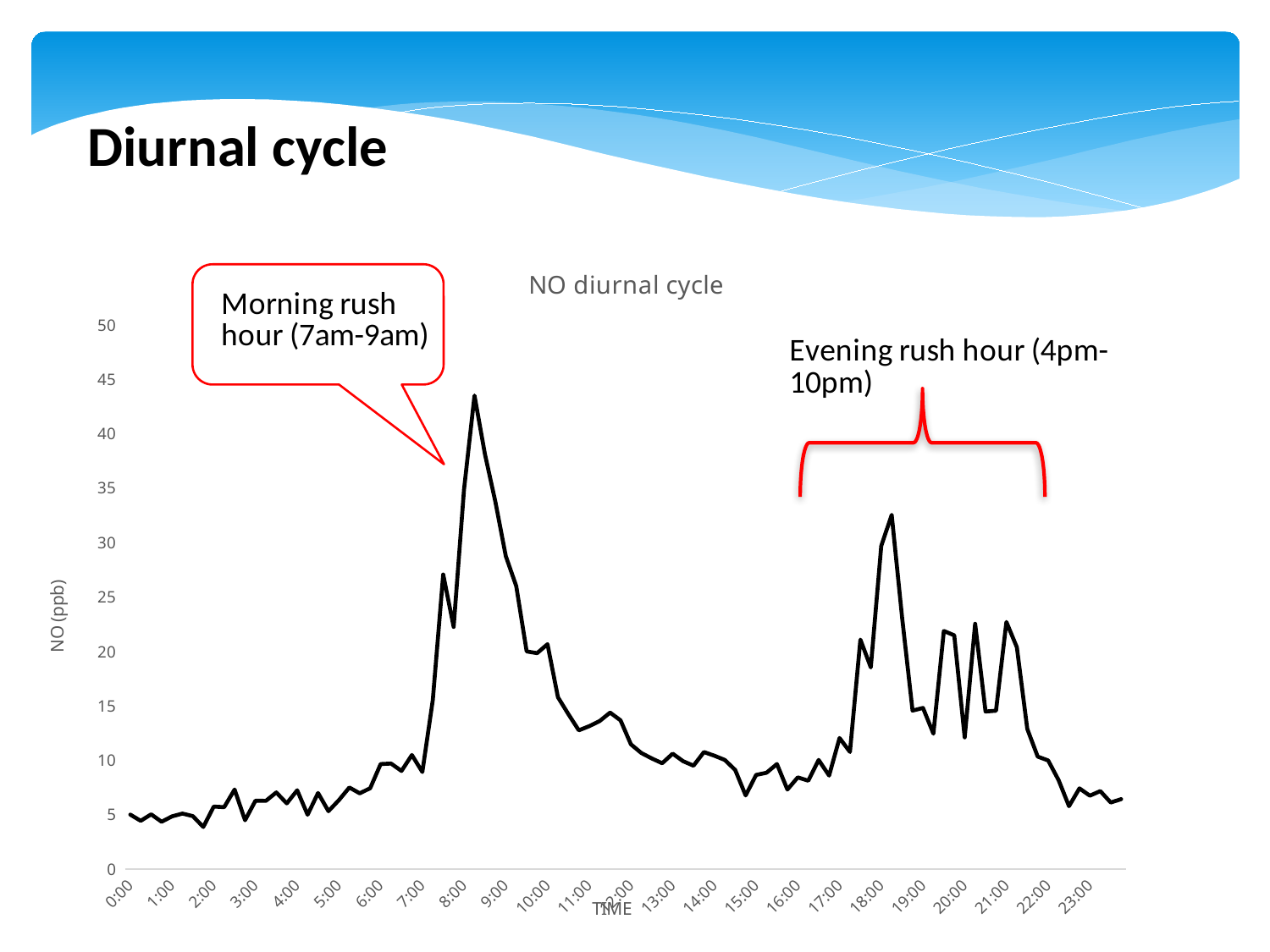
Between 9:00 and 15:00, do NO values generally rise or fall? fall Is the NO value at 23:00 greater or less than 10 ppb? less How many hourly time labels are shown on the x axis? 24 Between 0:00 and 7:00, do NO values generally rise or fall? rise What kind of chart is shown on the slide? line chart Which is higher, the morning rush hour peak or the evening rush hour peak? morning rush hour peak Is the NO value at 0:00 greater or less than 10 ppb? less What is the title of the chart? NO diurnal cycle What is the label of the vertical axis? NO (ppb) Is the NO value at 15:00 greater or less than 10 ppb? less